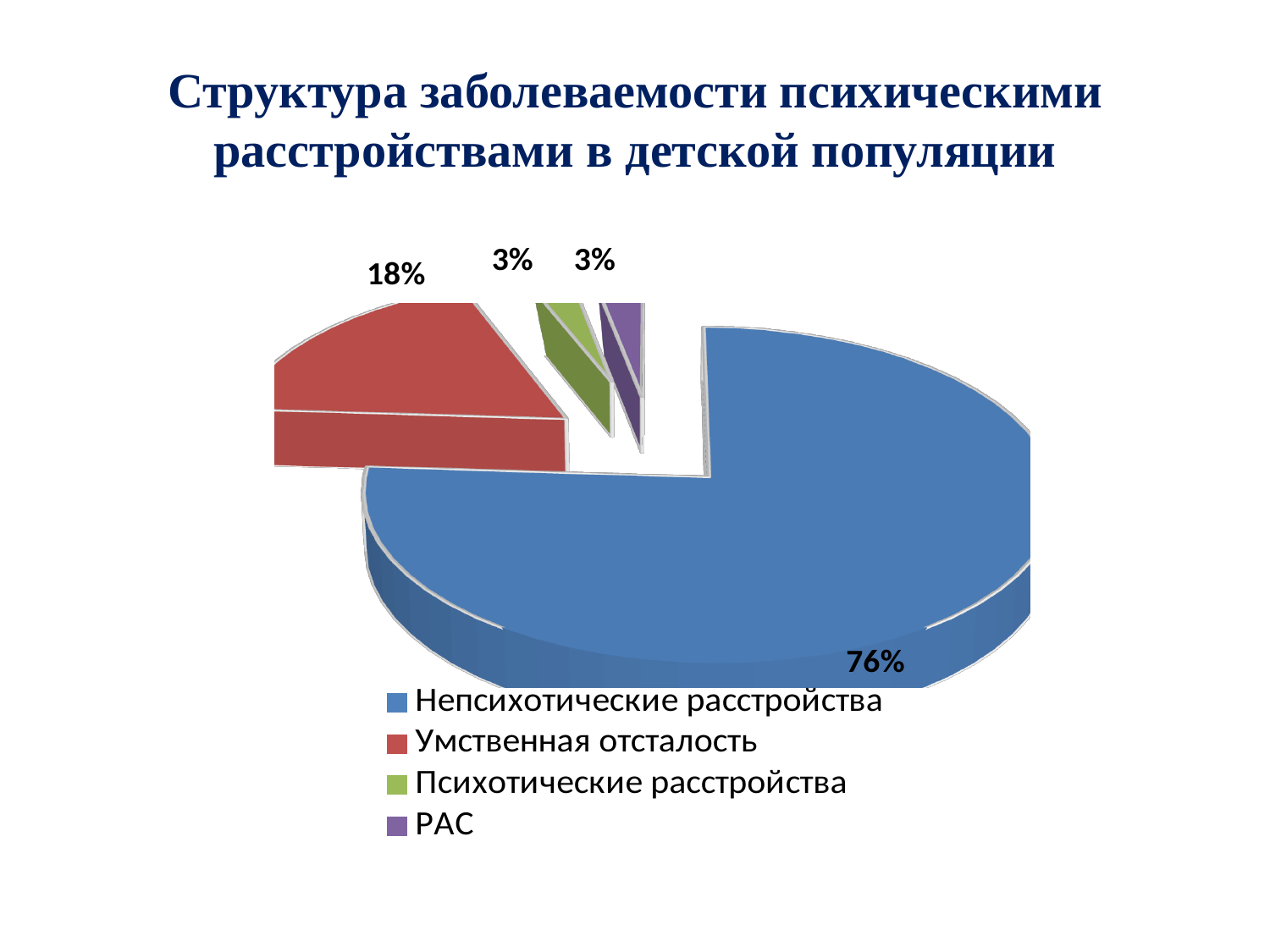
What is the combined share of Психотические расстройства and РАС? 6% What is the value shown for Умственная отсталость? 18% Which is larger, the share of Умственная отсталость or the share of РАС? Умственная отсталость What is the difference between the shares of Непсихотические расстройства and Умственная отсталость? 58% Which category has the largest slice of the pie? Непсихотические расстройства What is the value shown for РАС? 3% What share of the pie does Непсихотические расстройства account for? 76% How many categories are shown in the pie chart? 4 What is the value shown for Психотические расстройства? 3% Which colour represents Умственная отсталость in the legend? Red What kind of chart is shown on the slide? Pie chart What is the title of the slide? Структура заболеваемости психическими расстройствами в детской популяции